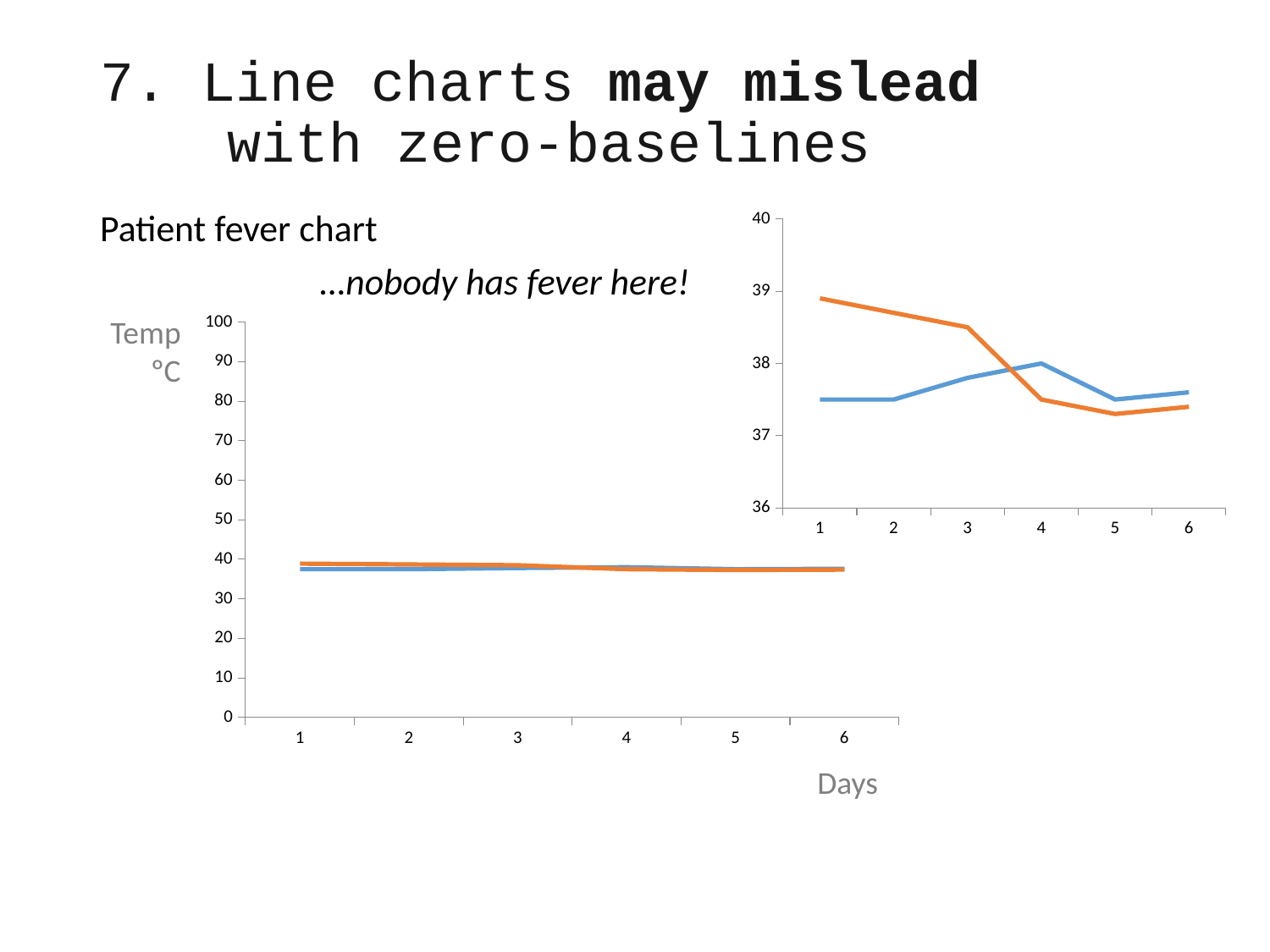
In the small chart at the top right, on which day is the orange line at its highest? 1 What is the lowest value shown on the y axis of the small chart at the top right? 36 In the small chart at the top right, is the value of the blue line on day 1 greater or less than 38? less In the small chart at the top right, is the value of the orange line on day 1 greater or less than 38? greater In the small chart at the top right, on which day is the blue line at its highest? 4 In the large 'Patient fever chart', is the value of the orange line on day 1 greater or less than 50? less In the small chart at the top right, does the orange line rise or fall from day 1 to day 5? fall What is the label on the y axis of the large 'Patient fever chart'? Temp °C What kind of chart is the large 'Patient fever chart' on the left? line chart In the small chart at the top right, which line is higher on day 1, the blue line or the orange line? orange How many days are shown on the x axis of the large 'Patient fever chart'? 6 In the small chart at the top right, which line is higher on day 4, the blue line or the orange line? blue